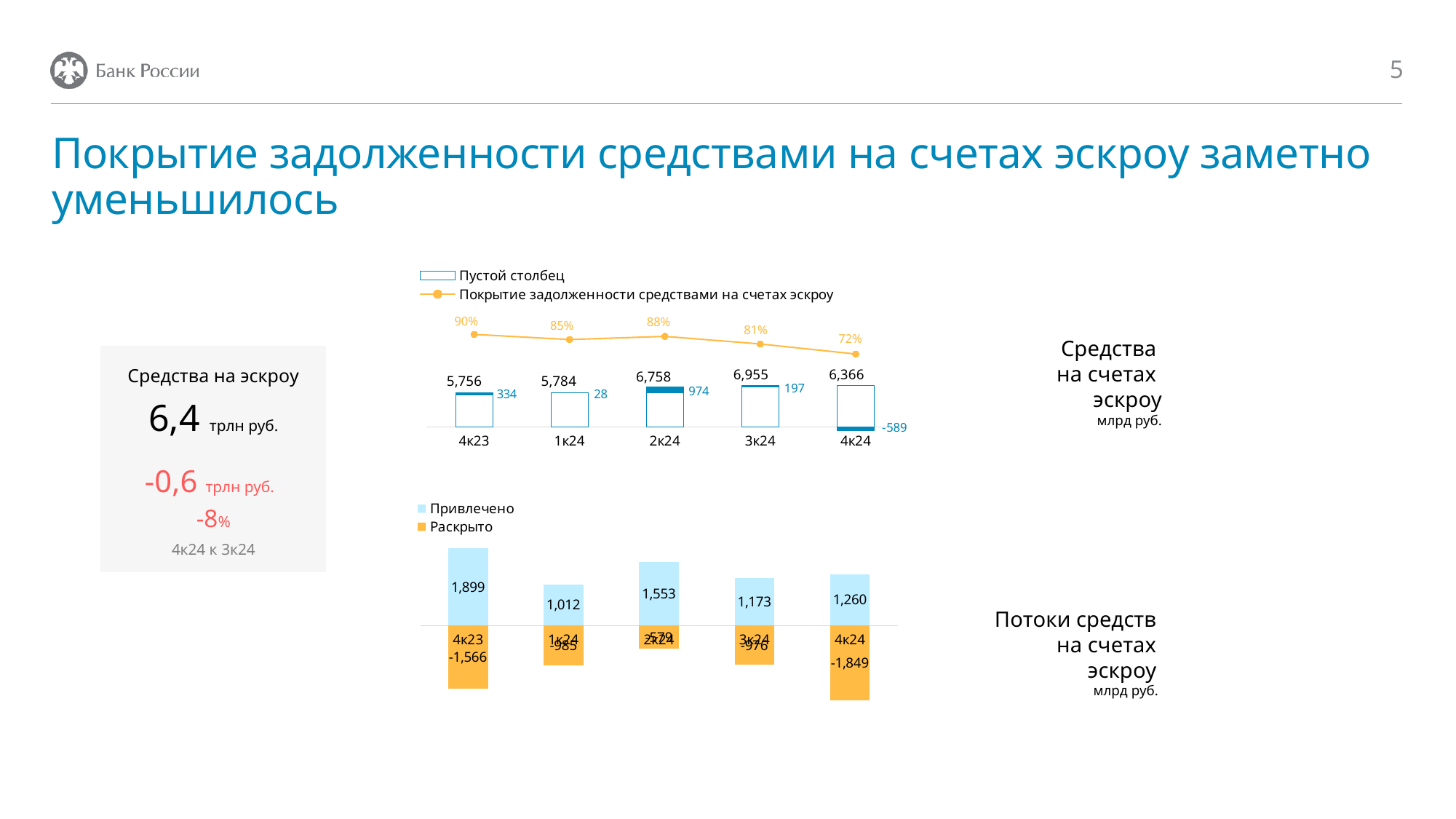
In the top chart (Средства на счетах эскроу), which quarter has the highest value? 3к24 In the top chart (Средства на счетах эскроу), which quarter has the lowest value? 4к23 In the bottom chart (Потоки средств на счетах эскроу), how many series does the legend list? 2 In the top chart (Средства на счетах эскроу), how many quarters are shown on the x axis? 5 In the bottom chart (Потоки средств на счетах эскроу), what is the Привлечено value for 4к23? 1,899 In the top chart (Средства на счетах эскроу), does the coverage line rise or fall from 3к24 to 4к24? fall In the top chart (Средства на счетах эскроу), what is the value for 4к23? 5,756 In the bottom chart (Потоки средств на счетах эскроу), which quarter has the highest Привлечено value? 4к23 In the top chart (Средства на счетах эскроу), what is the value for 3к24? 6,955 In the bottom chart (Потоки средств на счетах эскроу), what is the Раскрыто value for 4к24? -1,849 In the top chart (Средства на счетах эскроу), what is the difference between the values for 3к24 and 4к24? 589 In the top chart (Средства на счетах эскроу), what is the coverage percentage (Покрытие задолженности средствами на счетах эскроу) for 4к24? 72%